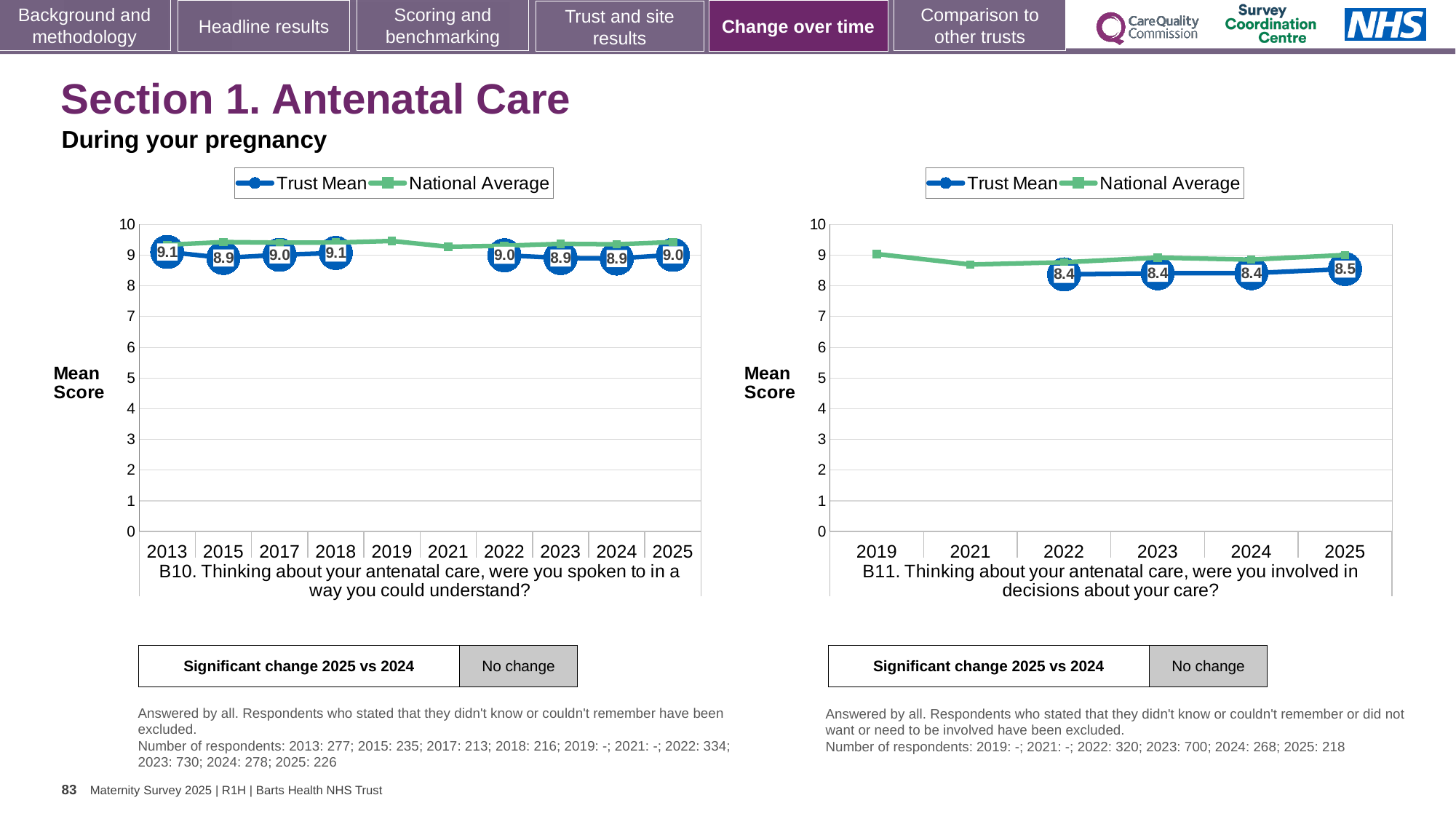
In the B10 chart on the left, what is the Trust Mean for 2025? 9.0 In the B11 chart on the right, what is the Trust Mean for 2022? 8.4 How many years are shown on the x axis of the B10 chart on the left? 10 What does the 'Significant change 2025 vs 2024' box below the B11 chart on the right say? No change How many series does the legend of the B11 chart on the right list? 2 In the B11 chart on the right, what is the Trust Mean for 2025? 8.5 In the B11 chart on the right, is the National Average for 2019 greater or less than 8? greater In the B10 chart on the left, what is the Trust Mean for 2013? 9.1 In the B10 chart on the left, which is larger: the Trust Mean for 2018 or the Trust Mean for 2015? 2018 In the B10 chart on the left, what is the difference between the Trust Mean for 2013 and the Trust Mean for 2015? 0.2 How many years are shown on the x axis of the B11 chart on the right? 6 What kind of chart is the B10 chart on the left? Line chart